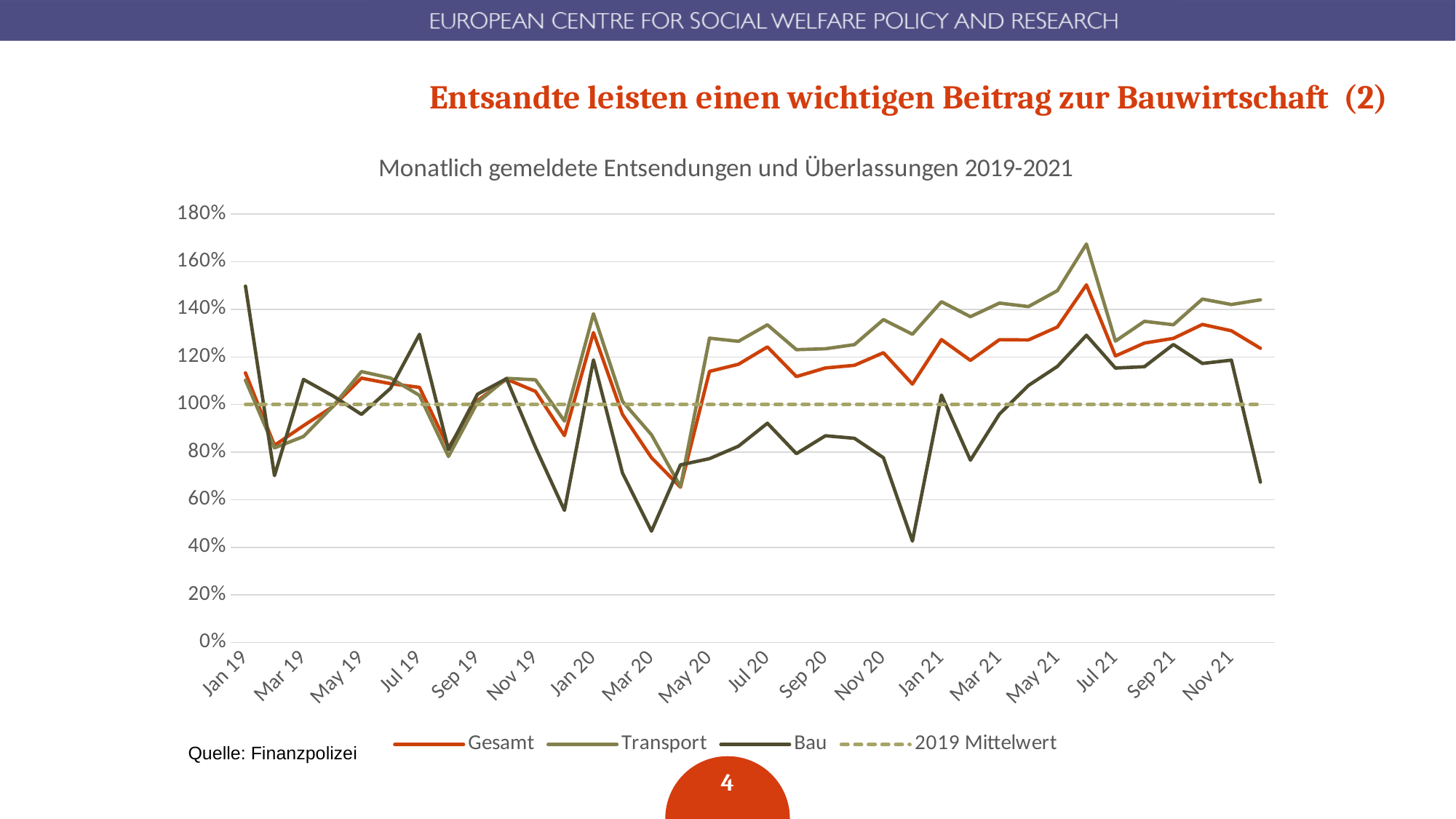
At what level is the 2019 Mittelwert line drawn? 100% How many series does the chart legend list? 4 What is the title of the chart? Monatlich gemeldete Entsendungen und Überlassungen 2019-2021 How many labels are shown on the x axis? 18 Is the value for Gesamt in May 20 greater or less than 100%? greater Which series has the highest value in Jul 21? Transport Is the value for Bau in Jan 19 greater or less than 140%? greater Is the value for Transport in Jul 21 greater or less than 120%? greater What kind of chart is shown on the slide? Line chart Which series is drawn as a dashed line? 2019 Mittelwert In Nov 20, which is larger, Transport or Bau? Transport